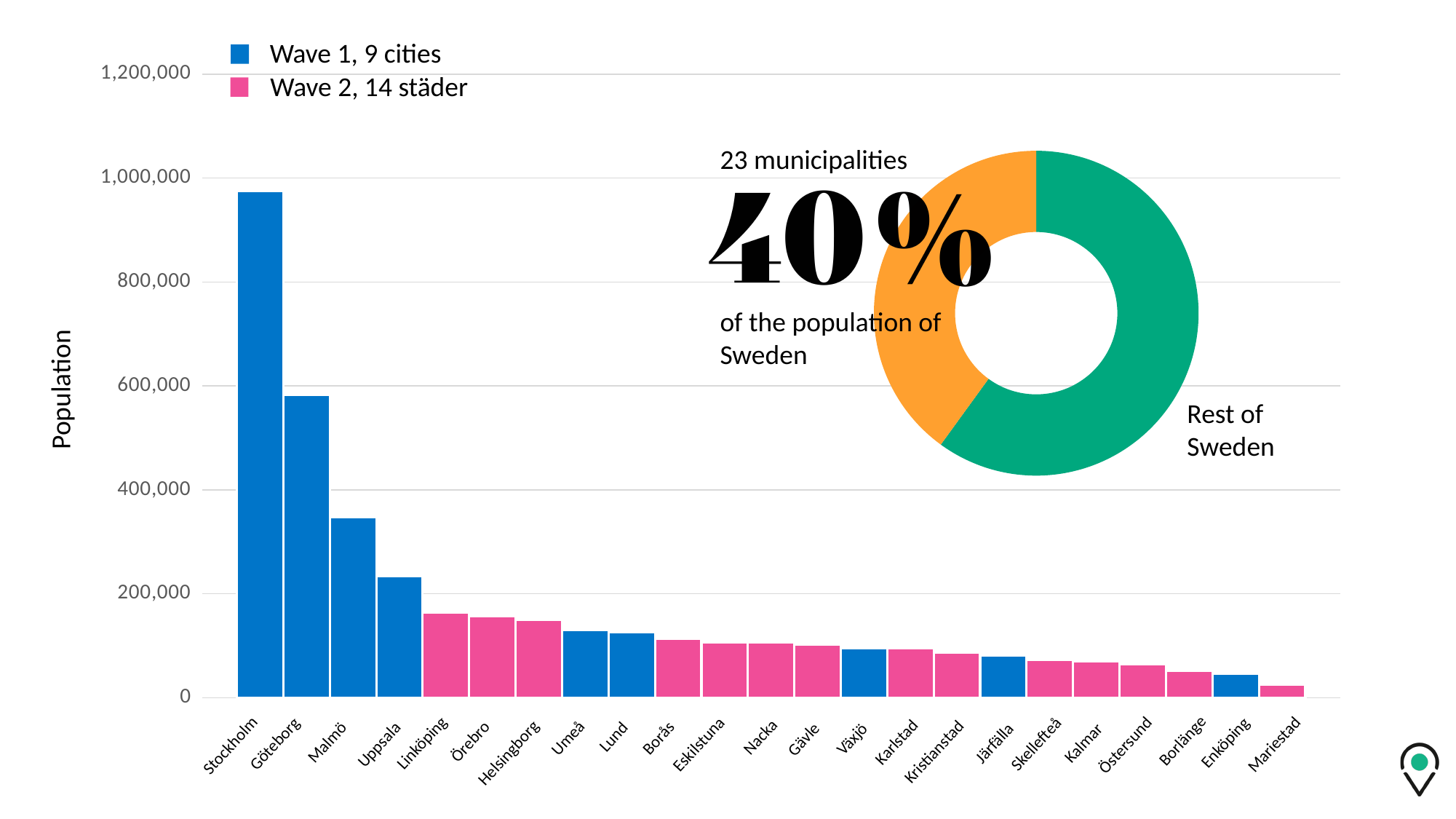
In the bar chart on the left, is the population of Stockholm greater or less than 800,000? greater In the bar chart on the left, which city has the highest population? Stockholm What kind of chart is the large chart on the left of the slide? bar chart In the bar chart on the left, is the population of Uppsala greater or less than 200,000? greater In the donut chart on the right, what share of the population of Sweden do the 23 municipalities represent? 40% In the bar chart on the left, do the populations rise or fall from left to right along the x axis? fall In the bar chart on the left, how many cities are shown on the x axis? 23 In the bar chart on the left, is the population of Malmö greater or less than 400,000? less In the bar chart on the left, which has the larger population, Göteborg or Malmö? Göteborg In the bar chart on the left, how many series does the legend list? 2 In the bar chart on the left, what are the two legend entries? Wave 1, 9 cities; Wave 2, 14 städer In the bar chart on the left, which city has the lowest population? Mariestad